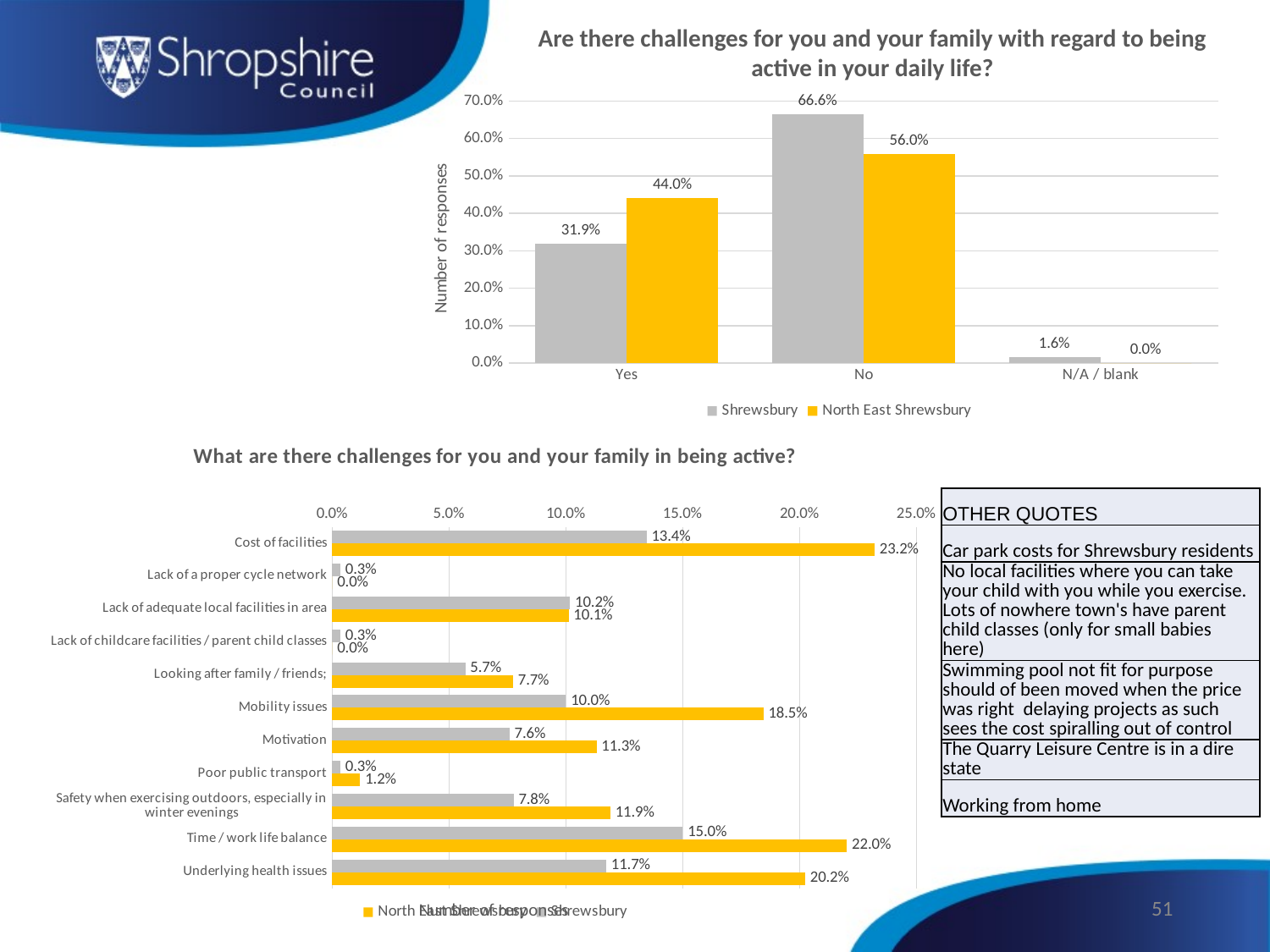
What type of chart is the top chart on the slide? Bar chart How many categories are shown on the bottom chart? 11 In the chart 'Are there challenges for you and your family with regard to being active in your daily life?', what is the Shrewsbury value for 'No'? 66.6% How many series does the legend of the top chart list? 2 In the chart 'What are there challenges for you and your family in being active?', what is the grey (Shrewsbury) value for 'Time / work life balance'? 15.0% In the chart 'What are there challenges for you and your family in being active?', what is the yellow (North East Shrewsbury) value for 'Cost of facilities'? 23.2% In the chart 'Are there challenges for you and your family with regard to being active in your daily life?', what is the North East Shrewsbury value for 'Yes'? 44.0% In the top chart, what is the difference between the Shrewsbury and North East Shrewsbury values for 'No'? 10.6% In the top chart, which series has the larger value for 'Yes', Shrewsbury or North East Shrewsbury? North East Shrewsbury In the bottom chart, is the yellow (North East Shrewsbury) value for 'Underlying health issues' greater or less than 15.0%? greater In the bottom chart, which category has the highest yellow (North East Shrewsbury) value? Cost of facilities In the bottom chart, what is the difference between the yellow and grey values for 'Mobility issues'? 8.5%